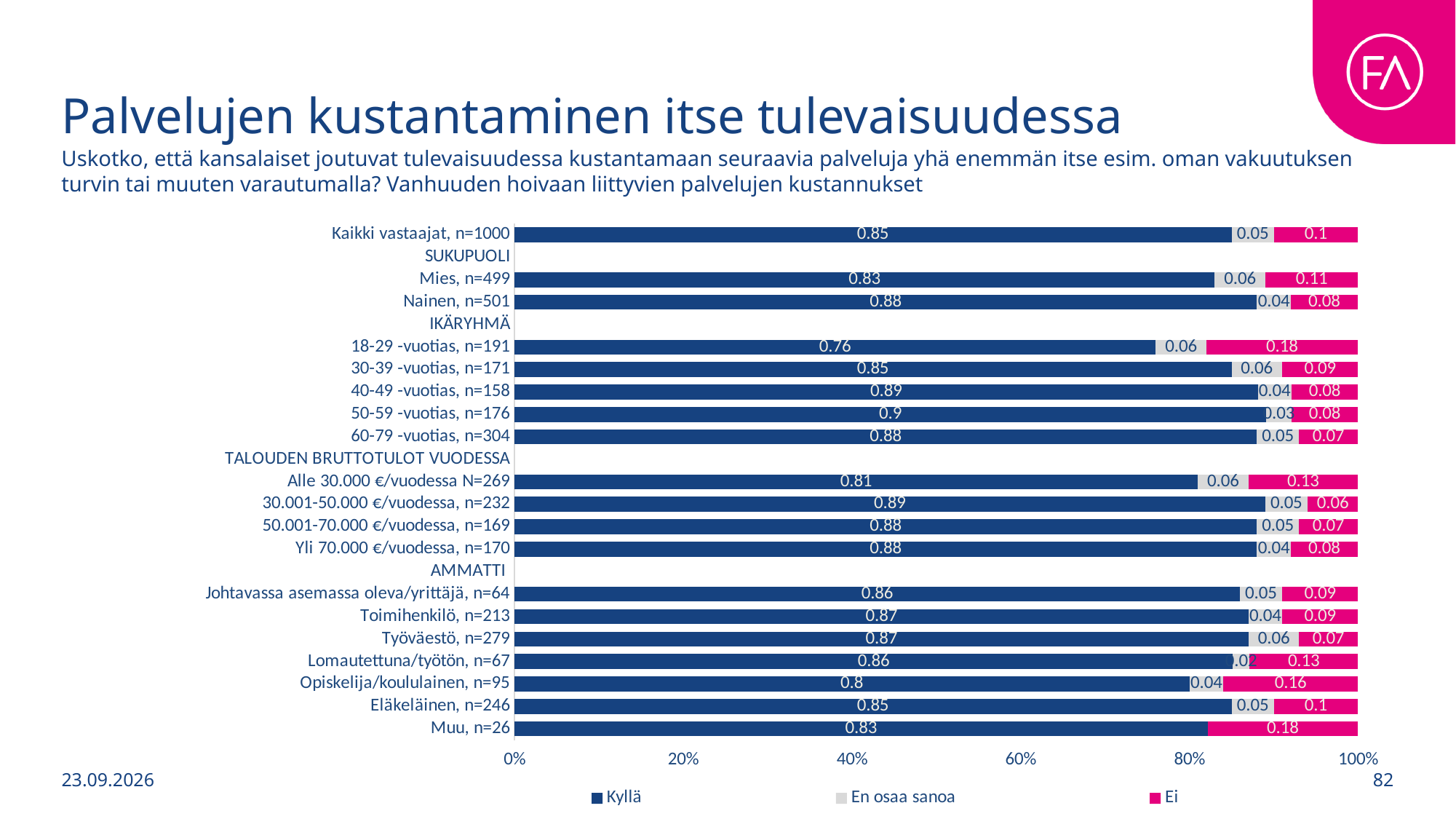
Which category has the highest Kyllä value? 50-59 -vuotias, n=176 What is the Ei value for Opiskelija/koululainen, n=95? 0.16 What kind of chart is shown on the slide? Stacked bar chart What is the Ei value for 18-29 -vuotias, n=191? 0.18 What is the Kyllä value for Kaikki vastaajat, n=1000? 0.85 Which category has the lowest Kyllä value? 18-29 -vuotias, n=191 What is the difference between the Kyllä values for Nainen, n=501 and Mies, n=499? 0.05 What is the En osaa sanoa value for Mies, n=499? 0.06 How many age groups (IKÄRYHMÄ) are shown in the chart? 5 How many series does the legend list? 3 Which has a larger Kyllä value, Mies, n=499 or Nainen, n=501? Nainen, n=501 Is the Kyllä value for 18-29 -vuotias, n=191 greater or less than 80%? less